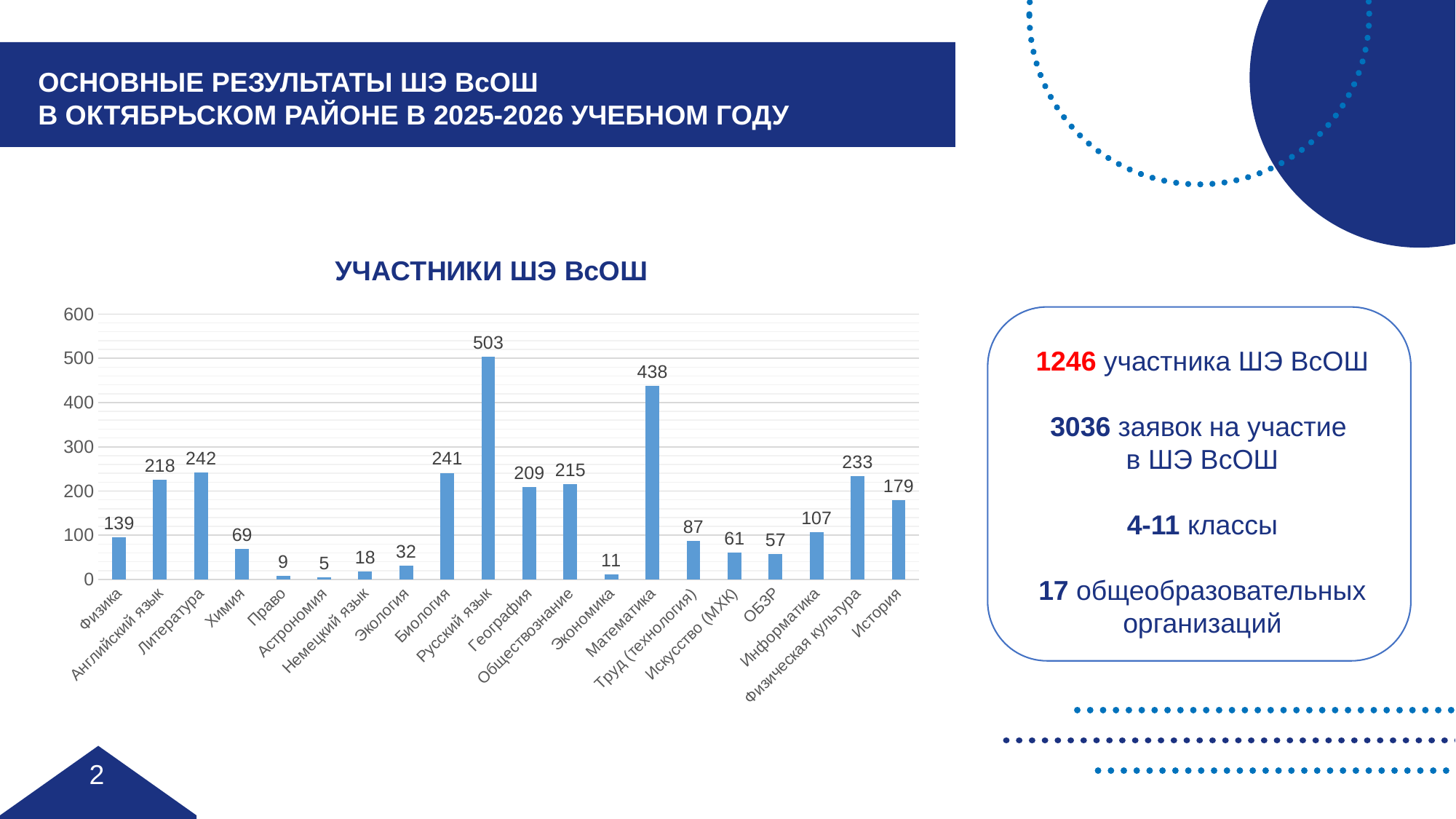
Which subject has the highest number of participants? Русский язык What type of chart is shown on the slide? Bar chart What is the difference between the values for Русский язык and Математика? 65 Which has a larger value, Математика or Физическая культура? Математика What is the value for Информатика? 107 How many subjects (categories) are shown in the chart? 20 What is the title of the chart? УЧАСТНИКИ ШЭ ВсОШ What is the difference between the values for История and Физика? 40 What is the value for Труд (технология)? 87 What is the value for Русский язык in the chart? 503 Which subject has the lowest number of participants? Астрономия How many participants are shown for Физика? 139